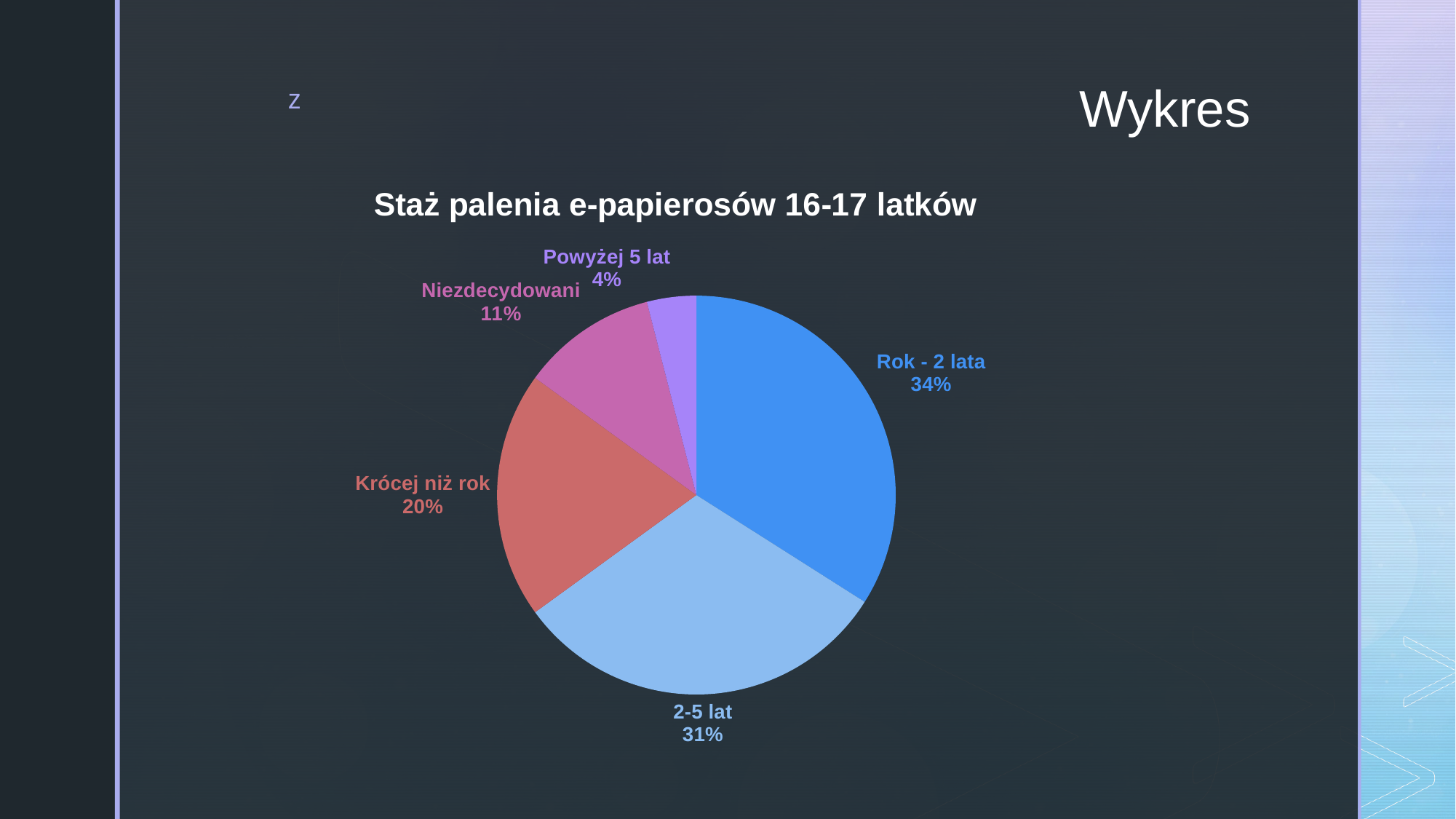
Which category has the smallest slice of the pie? Powyżej 5 lat What is the title of the chart? Staż palenia e-papierosów 16-17 latków What type of chart is shown on the slide? pie chart What share of the pie does "Rok - 2 lata" represent? 34% What percentage is shown for "Krócej niż rok"? 20% How many slices does the pie chart have? 5 What percentage is shown for "2-5 lat"? 31% What percentage is shown for "Powyżej 5 lat"? 4% Which is larger, the slice for "Niezdecydowani" or the slice for "Krócej niż rok"? Krócej niż rok Which category has the largest slice of the pie? Rok - 2 lata What is the difference in percentage points between "Rok - 2 lata" and "Krócej niż rok"? 14 What percentage is shown for "Niezdecydowani"? 11%